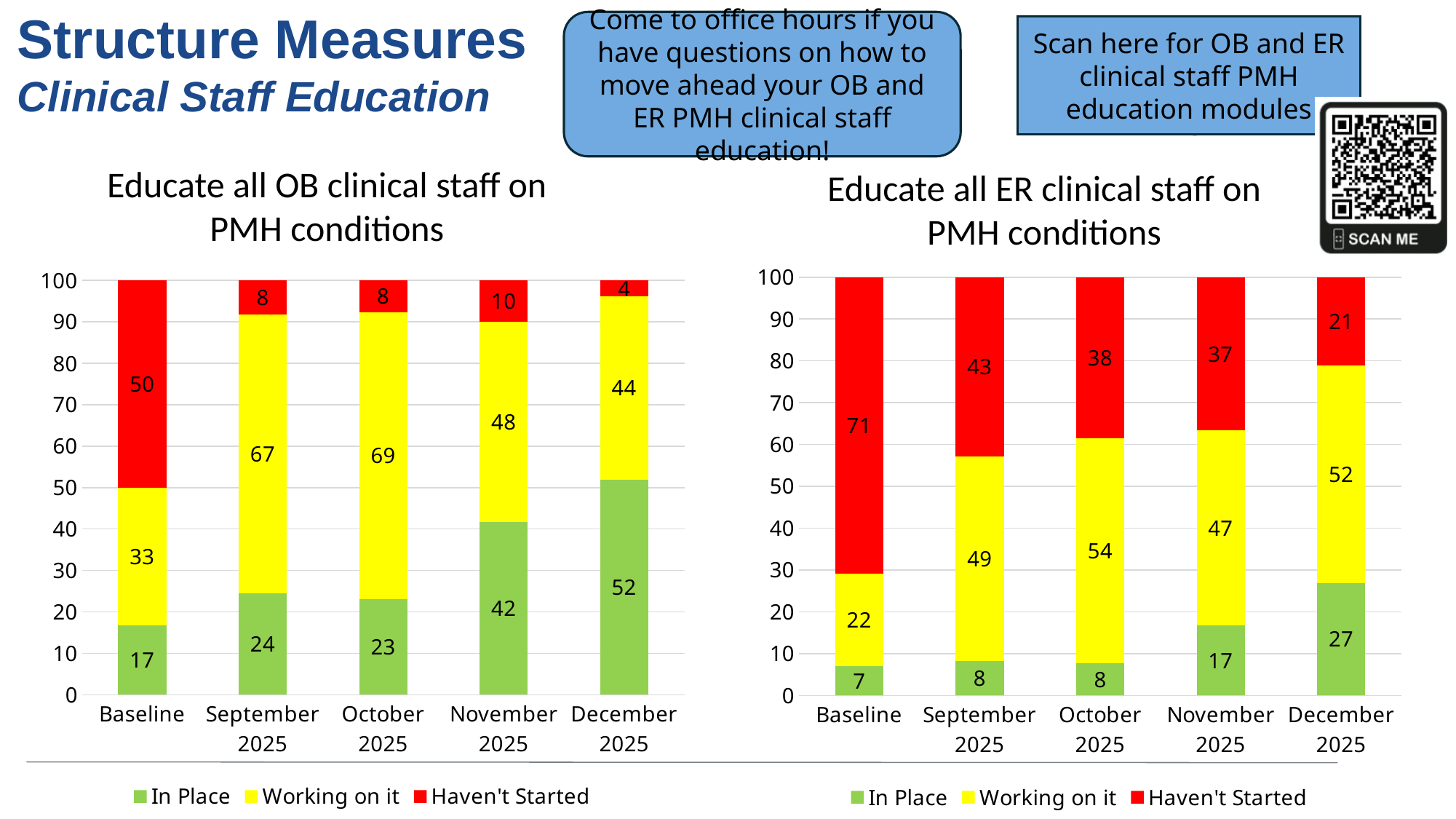
In the 'Educate all ER clinical staff on PMH conditions' chart, what is the 'Haven't Started' value for Baseline? 71 In the 'Educate all OB clinical staff on PMH conditions' chart, is the 'In Place' value for November 2025 larger than the 'In Place' value for September 2025? Yes In the 'Educate all OB clinical staff on PMH conditions' chart, what is the total of the Baseline stacked bar? 100 In the 'Educate all ER clinical staff on PMH conditions' chart, does the 'Haven't Started' value rise or fall from Baseline to December 2025? Fall In the 'Educate all OB clinical staff on PMH conditions' chart, which category has the lowest 'Haven't Started' value? December 2025 How many categories are shown on the x axis of the 'Educate all ER clinical staff on PMH conditions' chart? 5 What kind of chart is the 'Educate all ER clinical staff on PMH conditions' chart? Stacked bar chart In the 'Educate all OB clinical staff on PMH conditions' chart, what is the 'Working on it' value for October 2025? 69 How many series does the legend of the 'Educate all OB clinical staff on PMH conditions' chart list? 3 In the 'Educate all ER clinical staff on PMH conditions' chart, which month has the highest 'In Place' value? December 2025 In the 'Educate all OB clinical staff on PMH conditions' chart, what is the 'In Place' value for December 2025? 52 In the 'Educate all ER clinical staff on PMH conditions' chart, what is the difference between the 'Working on it' values for October 2025 and Baseline? 32